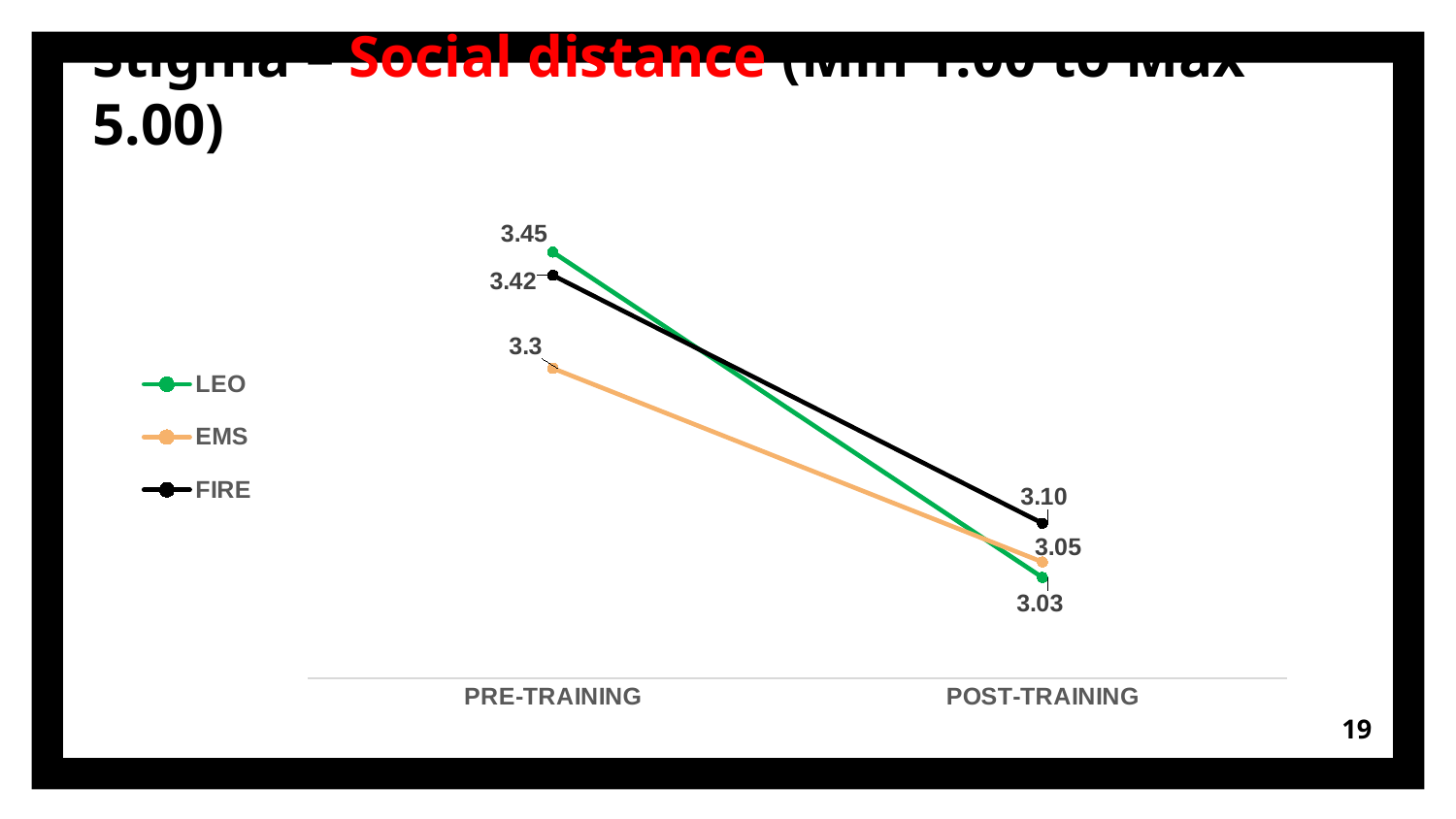
What is the PRE-TRAINING value for EMS? 3.3 What is the difference between the PRE-TRAINING values for FIRE and EMS? 0.12 What is the difference between the PRE-TRAINING and POST-TRAINING values for LEO? 0.42 What kind of chart is shown on the slide? Line chart Which series has the lowest POST-TRAINING value? LEO How many series does the legend list? 3 What is the POST-TRAINING value for FIRE? 3.10 What is the PRE-TRAINING value for LEO? 3.45 Which series has the highest PRE-TRAINING value? LEO Do the values for FIRE rise or fall from PRE-TRAINING to POST-TRAINING? Fall What is the POST-TRAINING value for EMS? 3.05 Which is larger, the POST-TRAINING value for FIRE or for EMS? FIRE